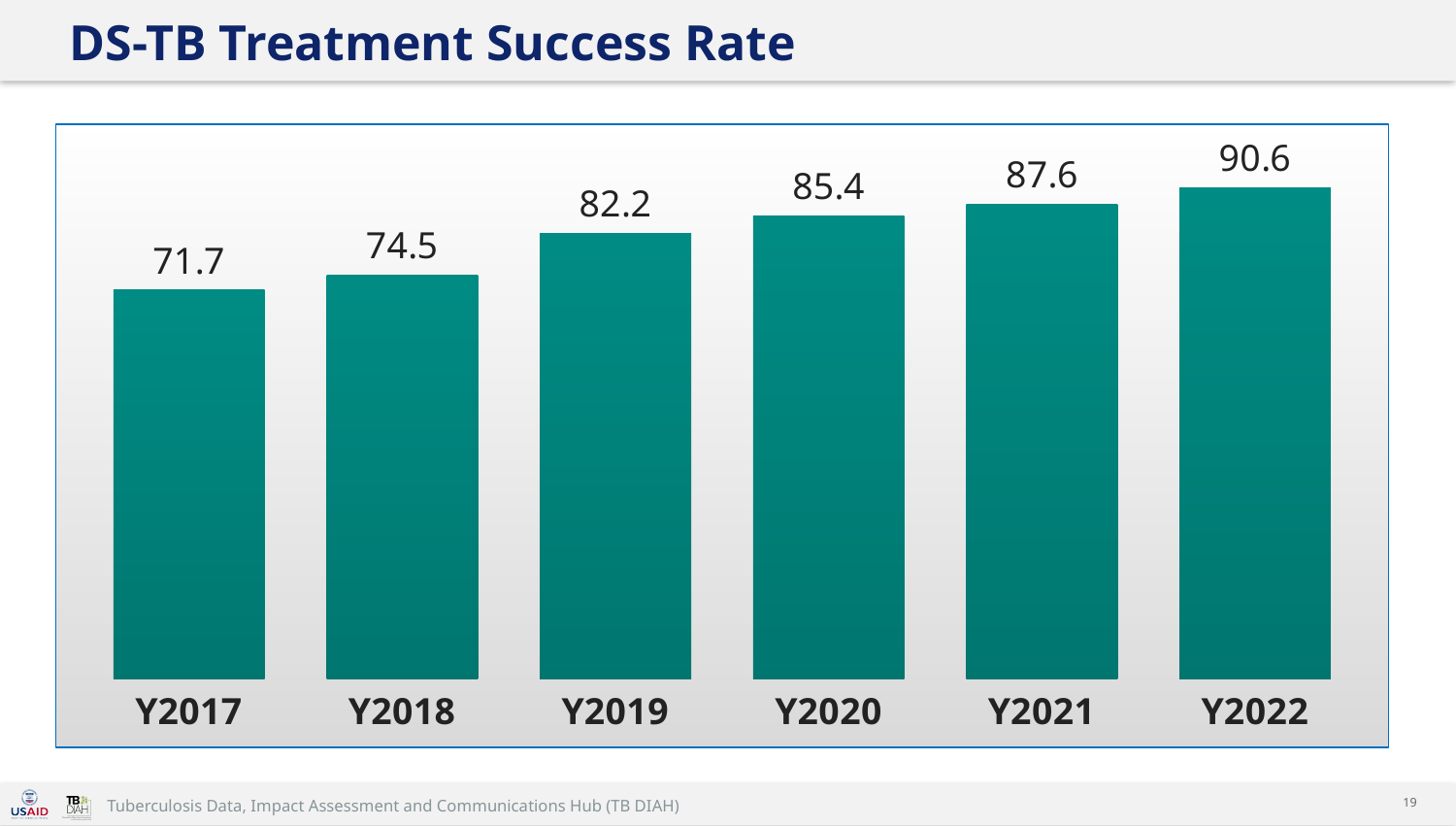
Which year has a higher DS-TB treatment success rate, Y2019 or Y2021? Y2021 What is the DS-TB treatment success rate for Y2017? 71.7 Does the DS-TB treatment success rate rise or fall from Y2017 to Y2022? Rise What is the difference between the DS-TB treatment success rate in Y2019 and Y2018? 7.7 What is the difference between the DS-TB treatment success rate in Y2022 and Y2017? 18.9 Which year has the lowest DS-TB treatment success rate? Y2017 What is the DS-TB treatment success rate for Y2022? 90.6 What is the title of the slide? DS-TB Treatment Success Rate What is the DS-TB treatment success rate for Y2020? 85.4 How many years are shown in the chart? 6 Which year has the highest DS-TB treatment success rate? Y2022 What type of chart is shown on the slide? Bar chart